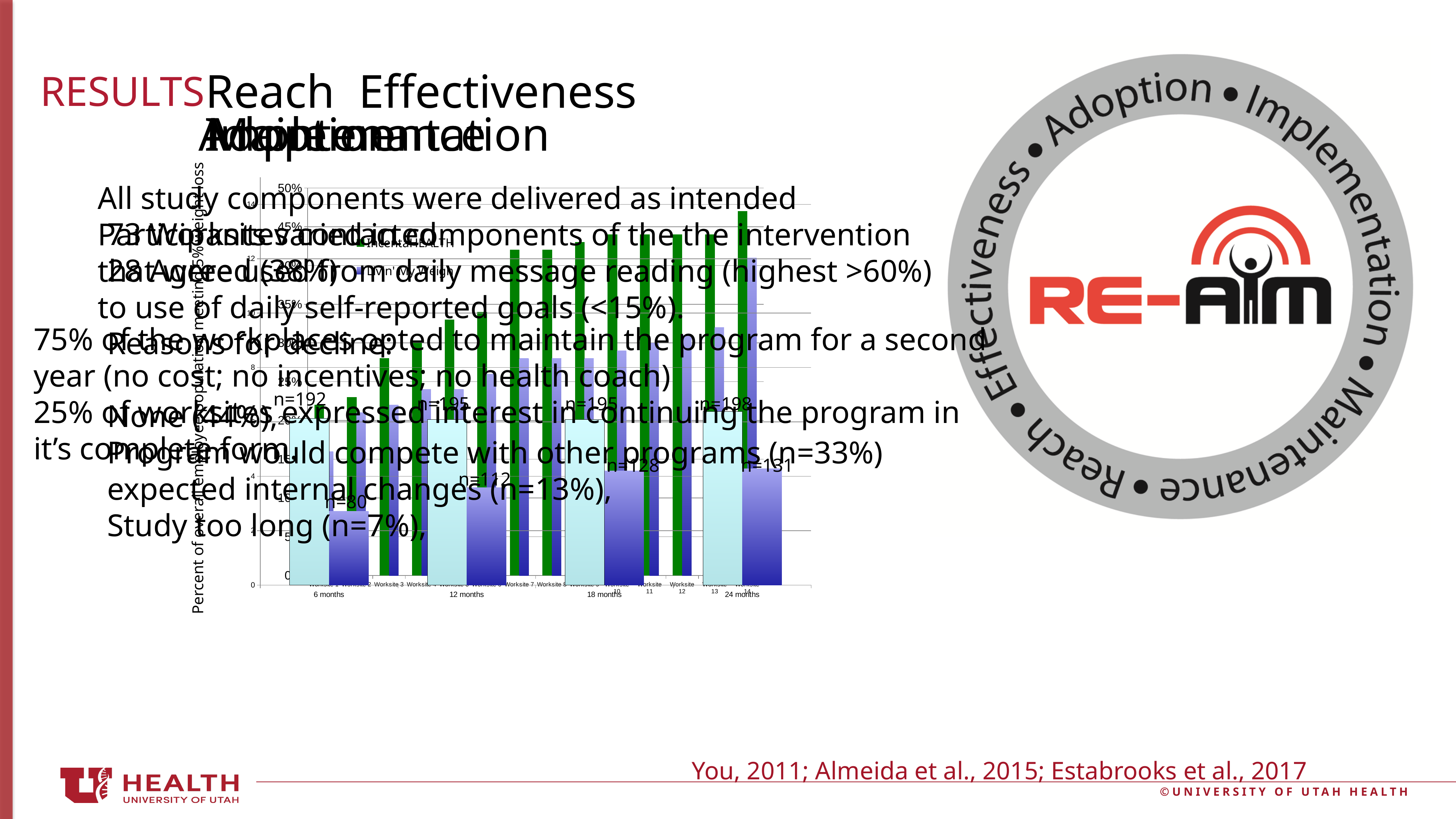
In the chart with time points, what is the label on the dark blue bar at 12 months? n=112 In the chart with time points, at which time point is the dark blue bar highest? 24 months What kind of chart is shown on the slide? bar chart In the chart with time points, how many time points are shown on the x axis? 4 In the chart with time points, what is the label on the dark blue bar at 24 months? n=131 In the chart with worksite categories, how many worksites are listed on the x axis? 14 In the chart with time points, what is the label on the light blue bar at 6 months? n=192 In the chart with time points, at which time point is the dark blue bar lowest? 6 months In the chart with time points, do the dark blue bars rise or fall from 6 months to 24 months? rise In the chart with time points, what is the label on the dark blue bar at 18 months? n=128 In the chart with time points, what is the label on the dark blue bar at 6 months? n=80 In the chart with time points, what is the label on the light blue bar at 24 months? n=198